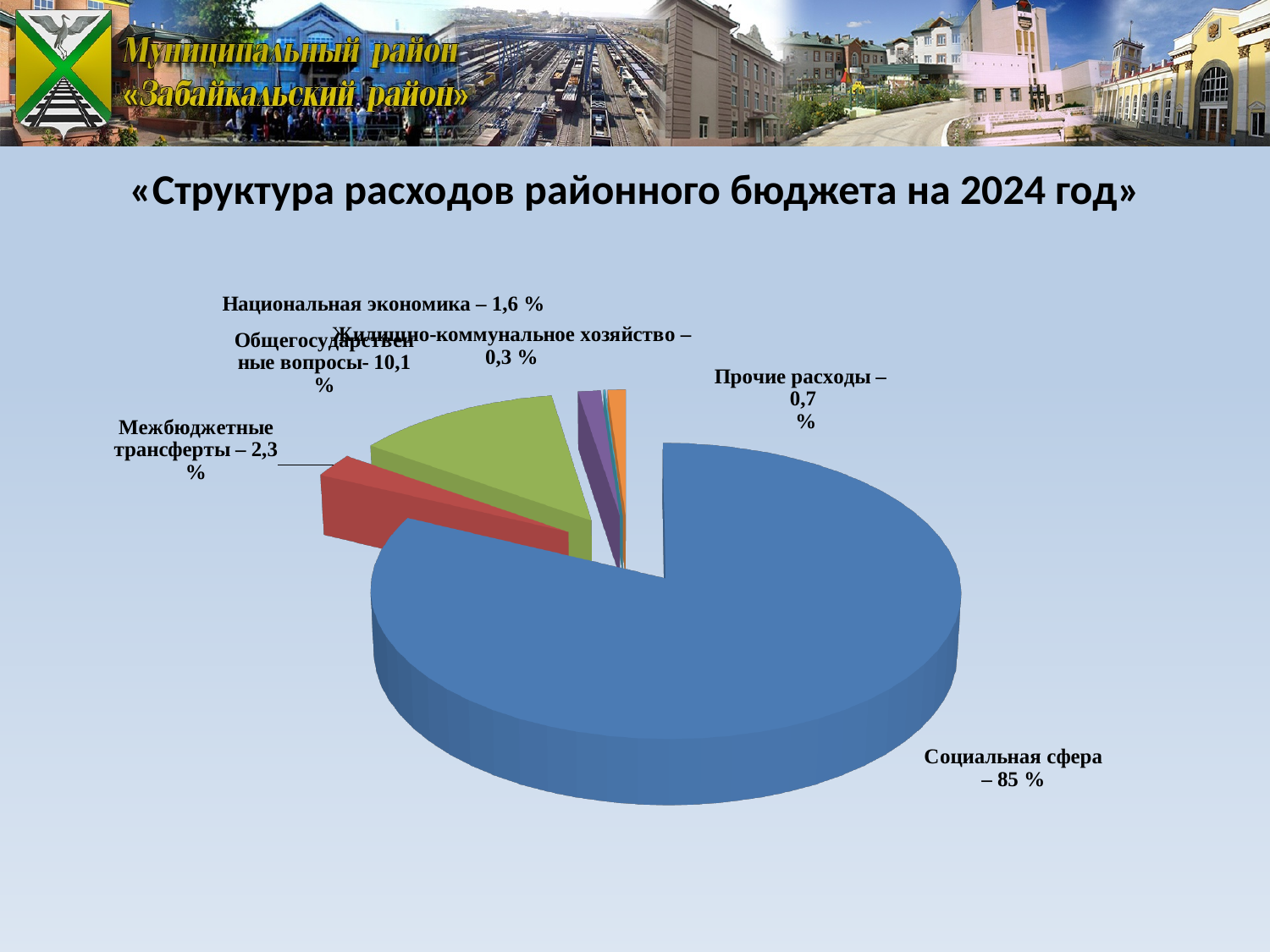
Which is larger, the share for Межбюджетные трансферты or the share for Национальная экономика? Межбюджетные трансферты What share of the district budget expenditure is labelled for Социальная сфера? 85 % What share is labelled for Межбюджетные трансферты? 2,3 % Which category has the smallest share of the pie? Жилищно-коммунальное хозяйство How many slices does the pie chart have? 6 What kind of chart is shown on the slide? Pie chart What share is labelled for Общегосударственные вопросы? 10,1 % What share is labelled for Прочие расходы? 0,7 % What share is labelled for Национальная экономика? 1,6 % Which category has the largest share of the pie? Социальная сфера What is the title of the chart on the slide? «Структура расходов районного бюджета на 2024 год» What share is labelled for Жилищно-коммунальное хозяйство? 0,3 %